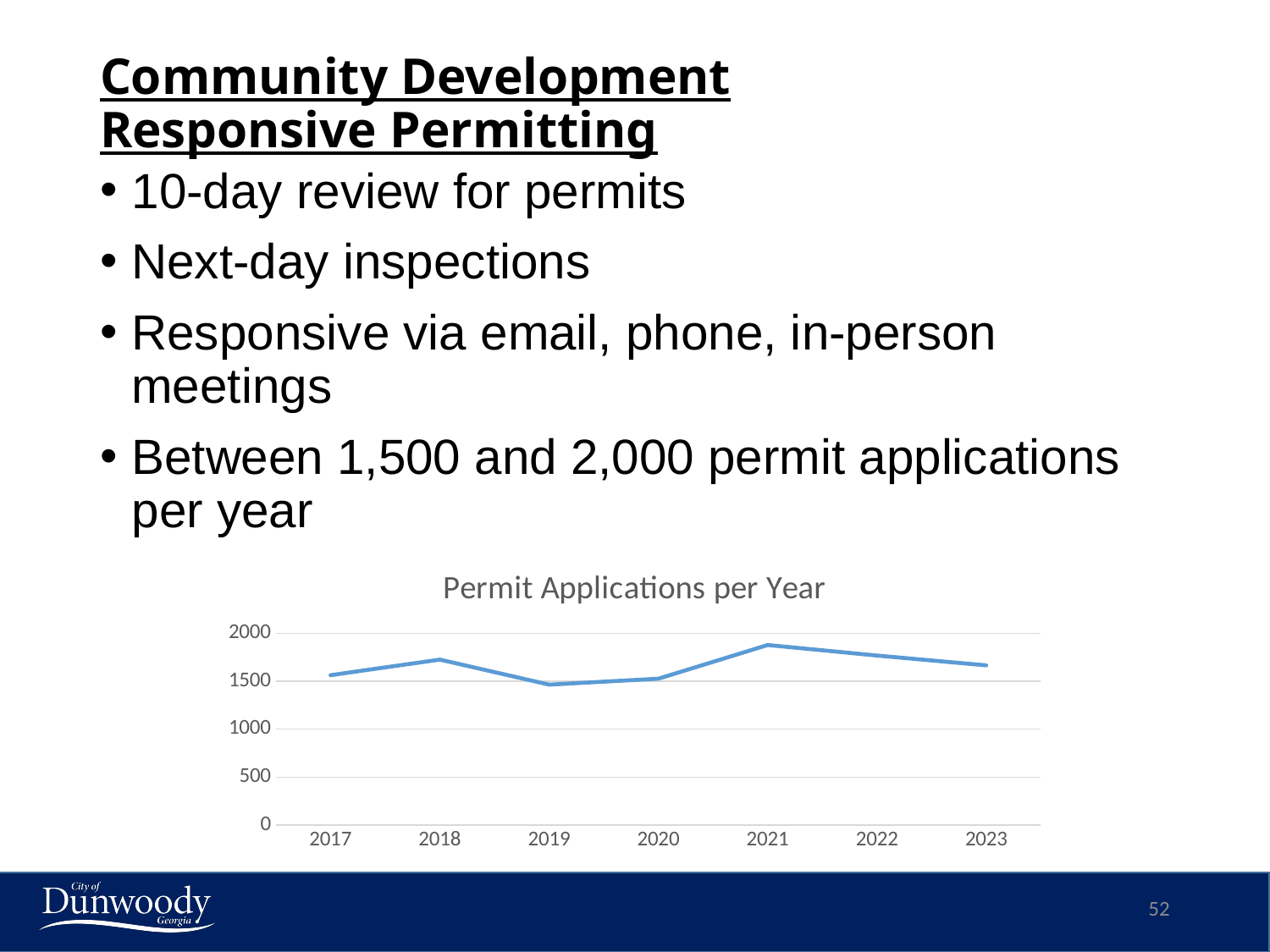
Is the value for 2017 greater or less than 1000? greater Do the values rise or fall from 2019 to 2021? rise What kind of chart is shown on the slide? line chart Which is larger, the value for 2021 or the value for 2019? 2021 What is the title of the chart? Permit Applications per Year Which is larger, the value for 2018 or the value for 2017? 2018 Is the value for 2018 greater or less than 1500? greater Is the value for 2021 greater or less than 1500? greater How many years are plotted on the x axis of the chart? 7 Which year has the highest number of permit applications? 2021 Do the values rise or fall from 2021 to 2023? fall